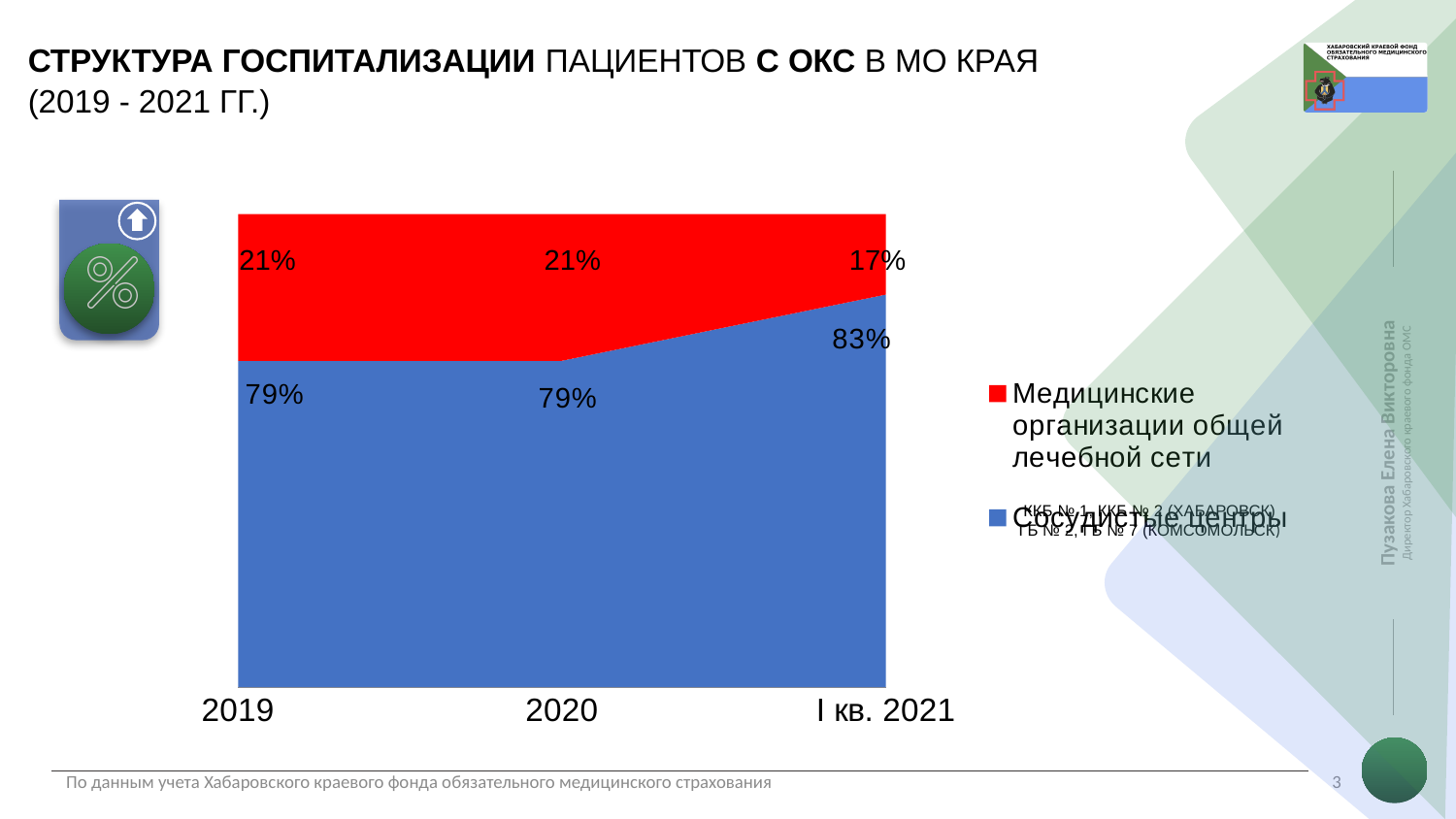
What kind of chart is shown on the slide? Stacked area chart What is the value for Сосудистые центры in I кв. 2021? 83% Which is larger in 2019: the share of Сосудистые центры or the share of Медицинские организации общей лечебной сети? Сосудистые центры How many periods are shown on the x axis? 3 Does the share of Сосудистые центры rise or fall from 2020 to I кв. 2021? Rise In which period is the share of Медицинские организации общей лечебной сети lowest? I кв. 2021 What is the value for Сосудистые центры in 2019? 79% What is the value for Медицинские организации общей лечебной сети in 2020? 21% What is the value for Медицинские организации общей лечебной сети in I кв. 2021? 17% What is the difference between the Сосудистые центры share in I кв. 2021 and in 2020? 4% How many series does the legend list? 2 In which period is the share of Сосудистые центры highest? I кв. 2021